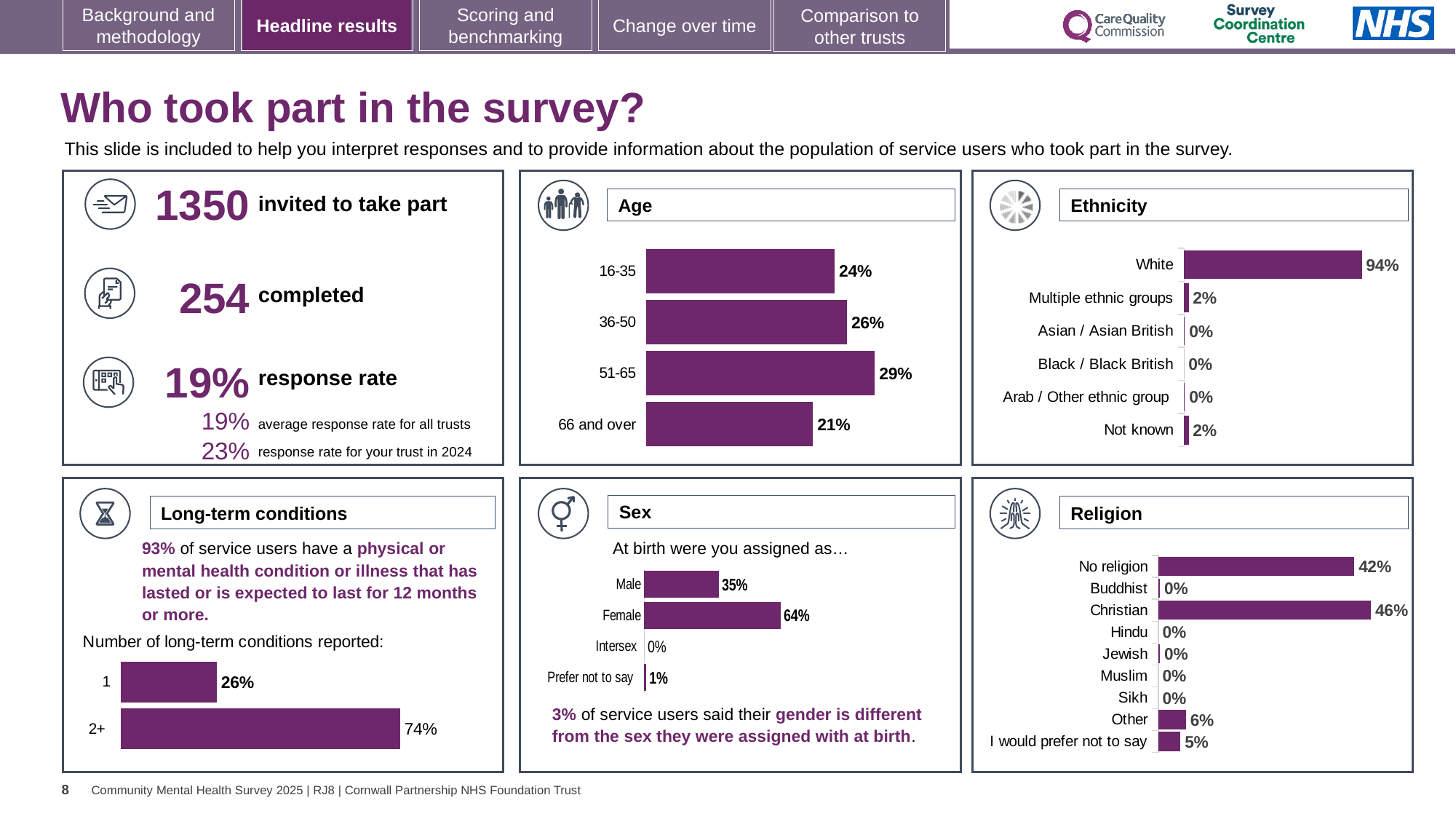
In the Religion chart, what percentage of respondents said they had no religion? 42% How many categories does the Ethnicity chart show? 6 What type of chart is used in the Age panel? Bar chart In the Religion chart, which category has the highest percentage? Christian In the Religion chart, what is the difference between Christian and No religion? 4% In the Long-term conditions chart, what percentage of service users reported 2+ long-term conditions? 74% In the Age chart, which age group has the lowest percentage? 66 and over In the Sex chart, which is larger, Male or Female? Female In the Age chart, what percentage of respondents were aged 51-65? 29% In the Age chart, what is the difference between the 36-50 and 16-35 percentages? 2% In the Ethnicity chart, what percentage of respondents were White? 94% In the Sex chart, what percentage of respondents were assigned Female at birth? 64%